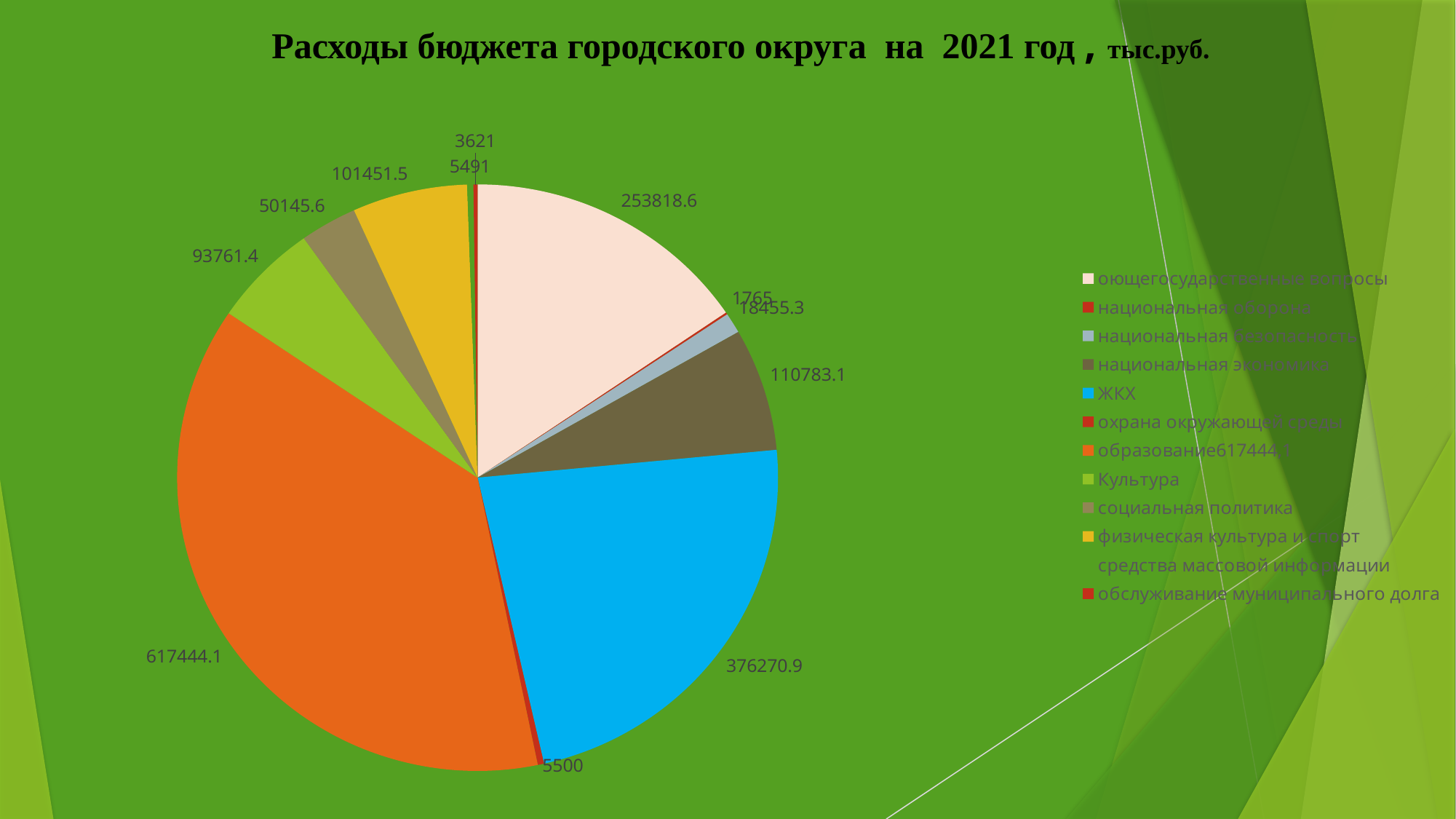
Which category has the smallest value? национальная оборона What unit is given in the chart title? тыс.руб. Which is larger, the value for Культура or the value for социальная политика? Культура What is the value for национальная оборона? 1765 What is the difference between the values for образование and ЖКХ? 241173.2 What is the value for национальная экономика? 110783.1 Which category has the largest slice of the pie? образование What is the value for образование? 617444.1 What kind of chart is shown on the slide? pie chart What is the value for ЖКХ? 376270.9 What is the value for физическая культура и спорт? 101451.5 How many categories does the pie chart have? 12